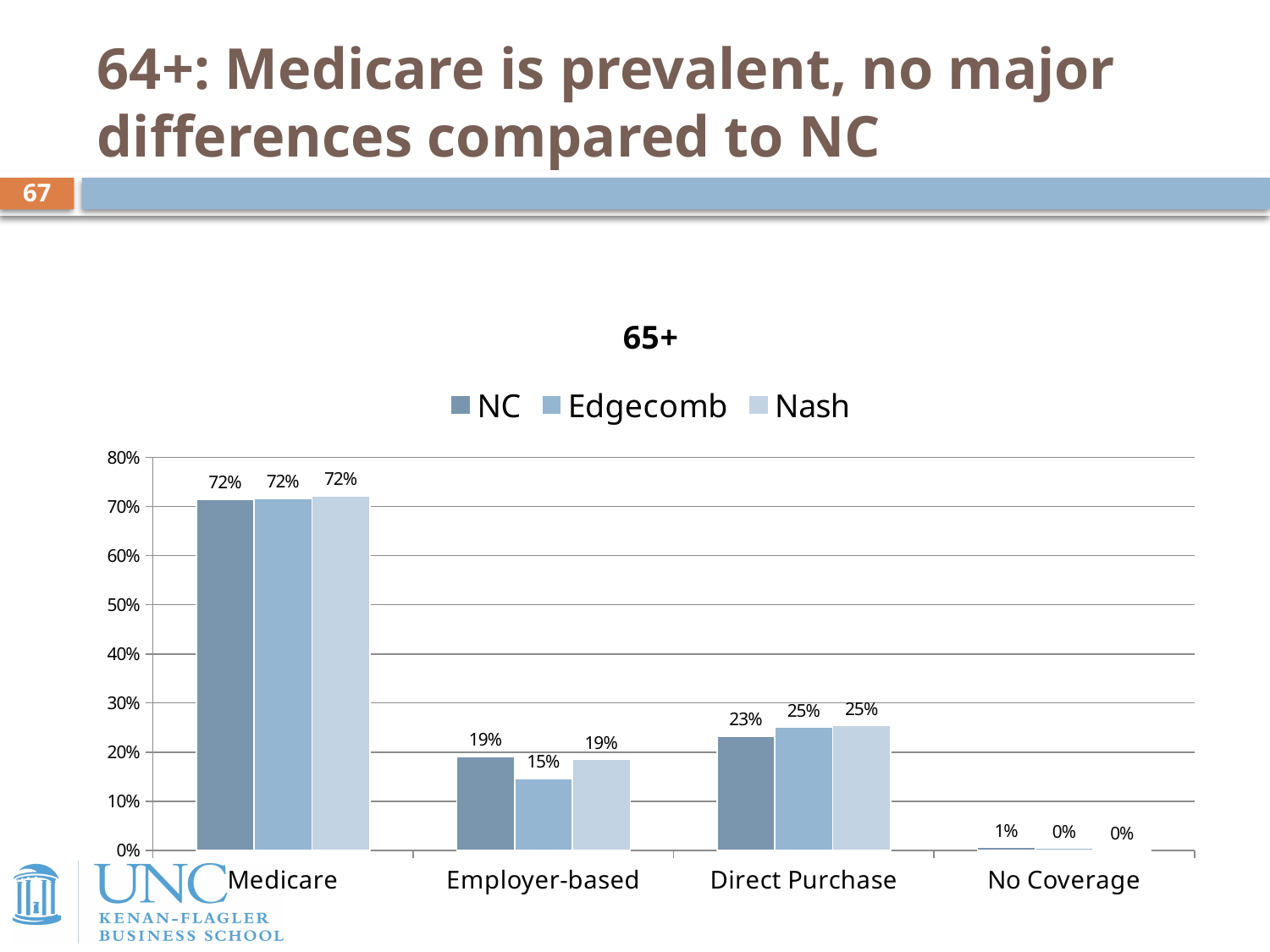
What is the value for Nash in the Medicare category? 72% What is the value for NC in the No Coverage category? 1% Which category has the lowest value for Nash? No Coverage Which category has the highest value for Edgecomb? Medicare What is the difference between the Nash and Edgecomb values in the Employer-based category? 4% How many series does the legend list? 3 How many categories are shown on the x axis? 4 What kind of chart is shown on the slide? Bar chart In the Direct Purchase category, which is larger: the NC value or the Edgecomb value? Edgecomb What is the value for Edgecomb in the Employer-based category? 15% What is the title of the chart? 65+ What is the value for NC in the Direct Purchase category? 23%